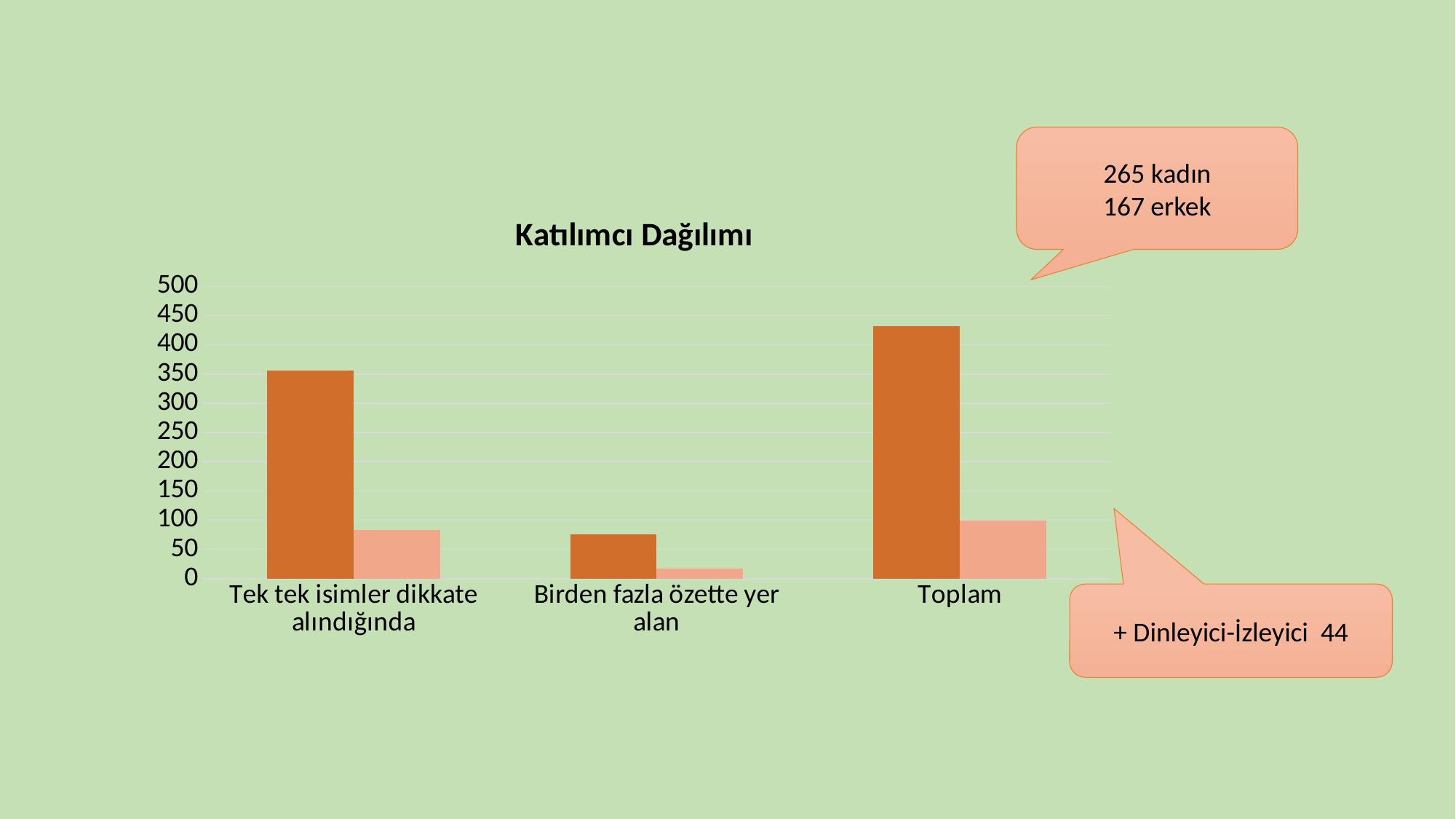
How many bars are plotted for each category in the chart? 2 Is the light orange bar for 'Tek tek isimler dikkate alındığında' greater or less than 100? less Is the dark orange bar for 'Toplam' greater or less than 400? greater Which category has the shortest bar in the chart? Birden fazla özette yer alan Which category has the tallest bar in the chart? Toplam What is the title of the chart? Katılımcı Dağılımı Is the dark orange bar for 'Birden fazla özette yer alan' greater or less than 100? less Which is larger: the dark orange bar for 'Tek tek isimler dikkate alındığında' or the dark orange bar for 'Toplam'? Toplam How many categories are shown on the x axis of the chart? 3 What kind of chart is shown on the slide? bar chart